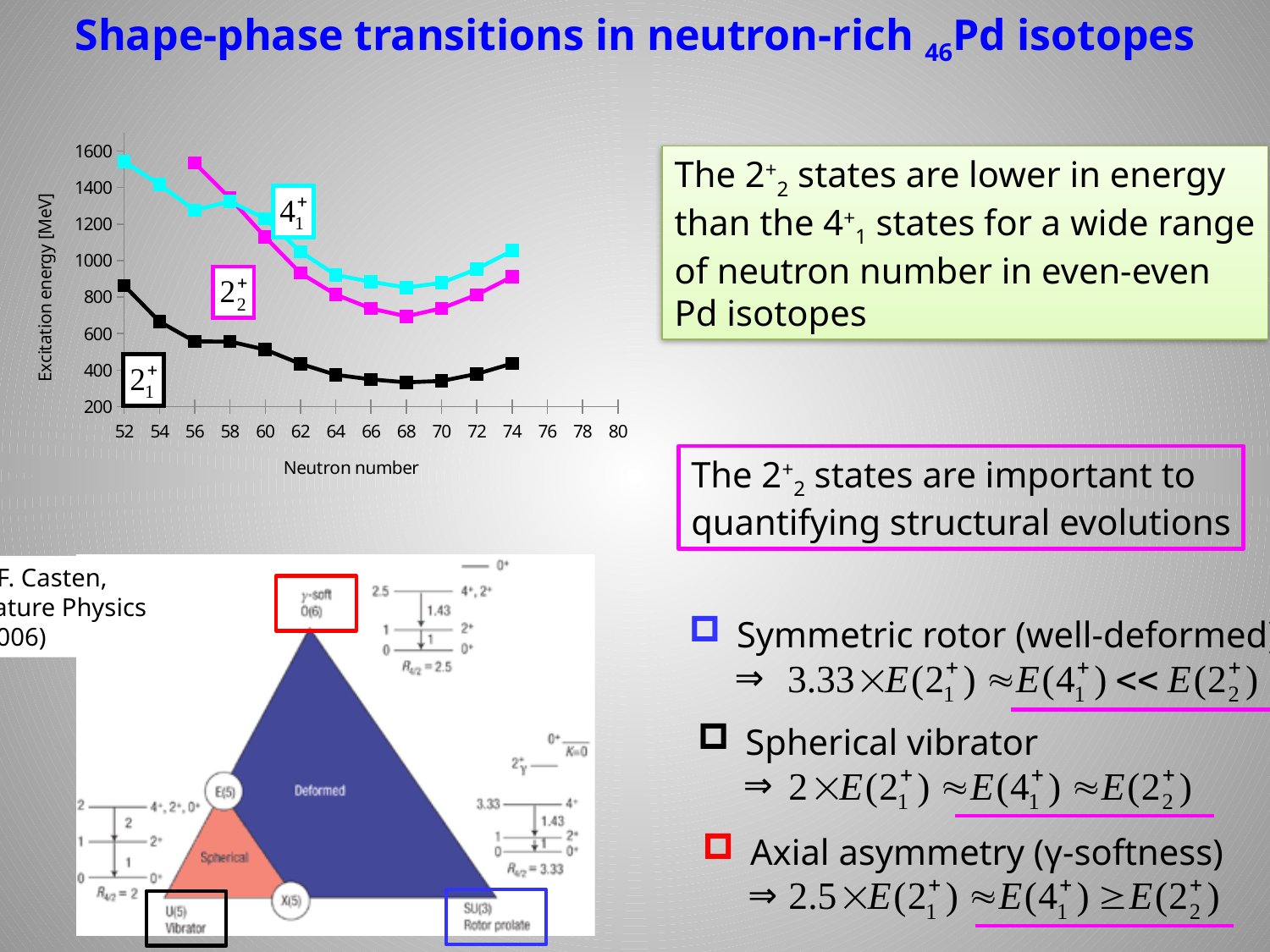
In the excitation energy chart, does the 2+1 series rise or fall from neutron number 52 to 68? fall In the excitation energy chart, is the value of the 4+1 series at neutron number 52 greater or less than 1400? greater In the excitation energy chart, at which neutron number does the 2+1 series reach its lowest value? 68 How many data series are plotted in the excitation energy chart? 3 In the excitation energy chart, is the value of the 2+1 series at neutron number 68 greater or less than 400? less What is the label of the y axis of the excitation energy chart? Excitation energy [MeV] In the excitation energy chart, is the value of the 2+2 series at neutron number 68 greater or less than 800? less What is the label of the x axis of the excitation energy chart? Neutron number In the excitation energy chart, at neutron number 68, which series has the higher value: 4+1 or 2+2? 4+1 What kind of chart is the excitation energy plot on the slide? line chart In the excitation energy chart, at neutron number 60, which series has the higher value: 2+2 or 2+1? 2+2